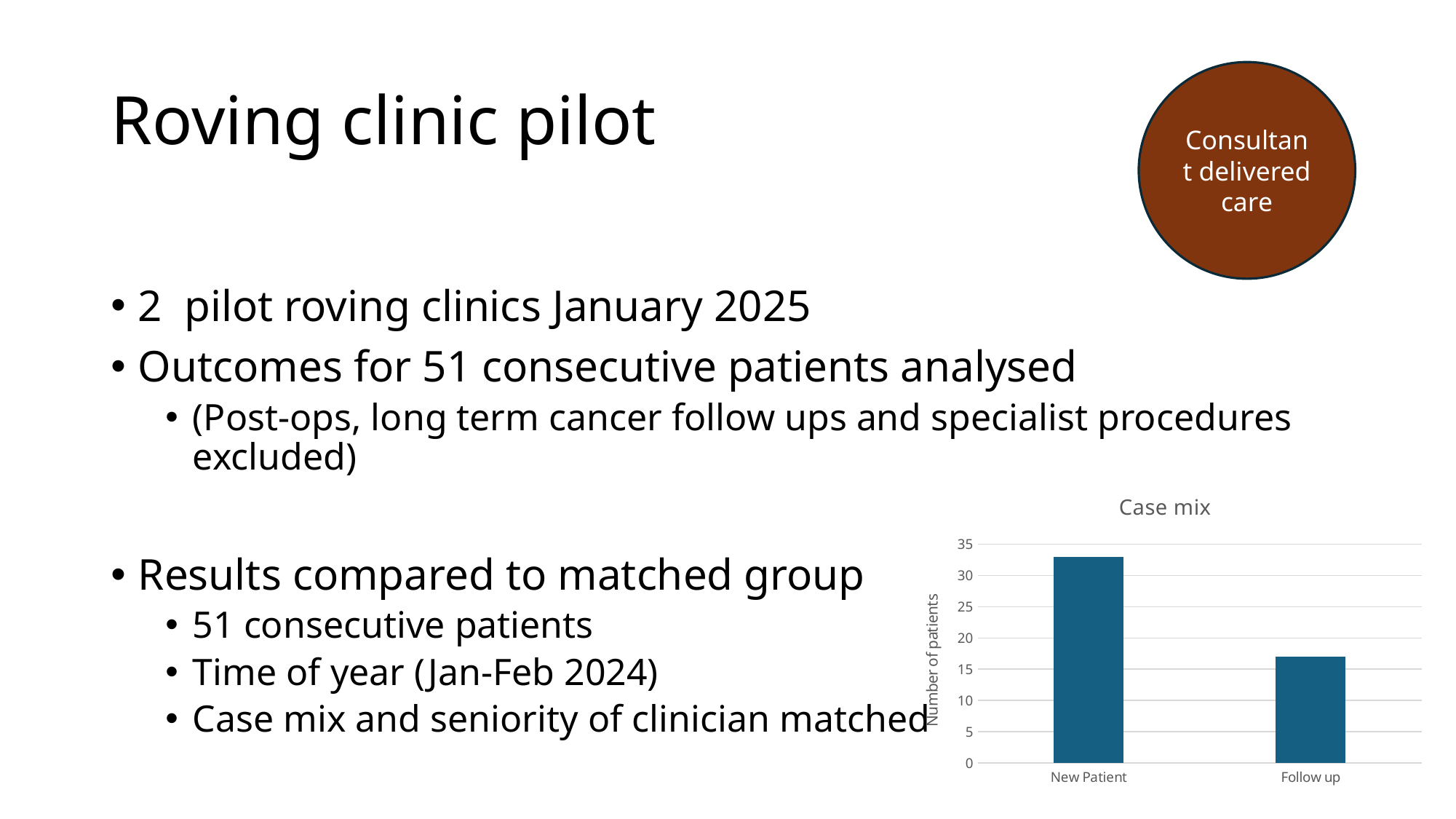
How many categories are shown in the "Case mix" chart? 2 In the "Case mix" chart, is the value for New Patient greater or less than 35? less In the "Case mix" chart, which is larger: New Patient or Follow up? New Patient In the "Case mix" chart, is the value for Follow up greater or less than 15? greater Do the values in the "Case mix" chart rise or fall from New Patient to Follow up? fall What kind of chart is the "Case mix" chart? bar chart Which category has the lowest value in the "Case mix" chart? Follow up What is the label on the vertical axis of the "Case mix" chart? Number of patients Which category has the highest value in the "Case mix" chart? New Patient In the "Case mix" chart, is the value for Follow up greater or less than 20? less What is the title of the chart on the slide? Case mix